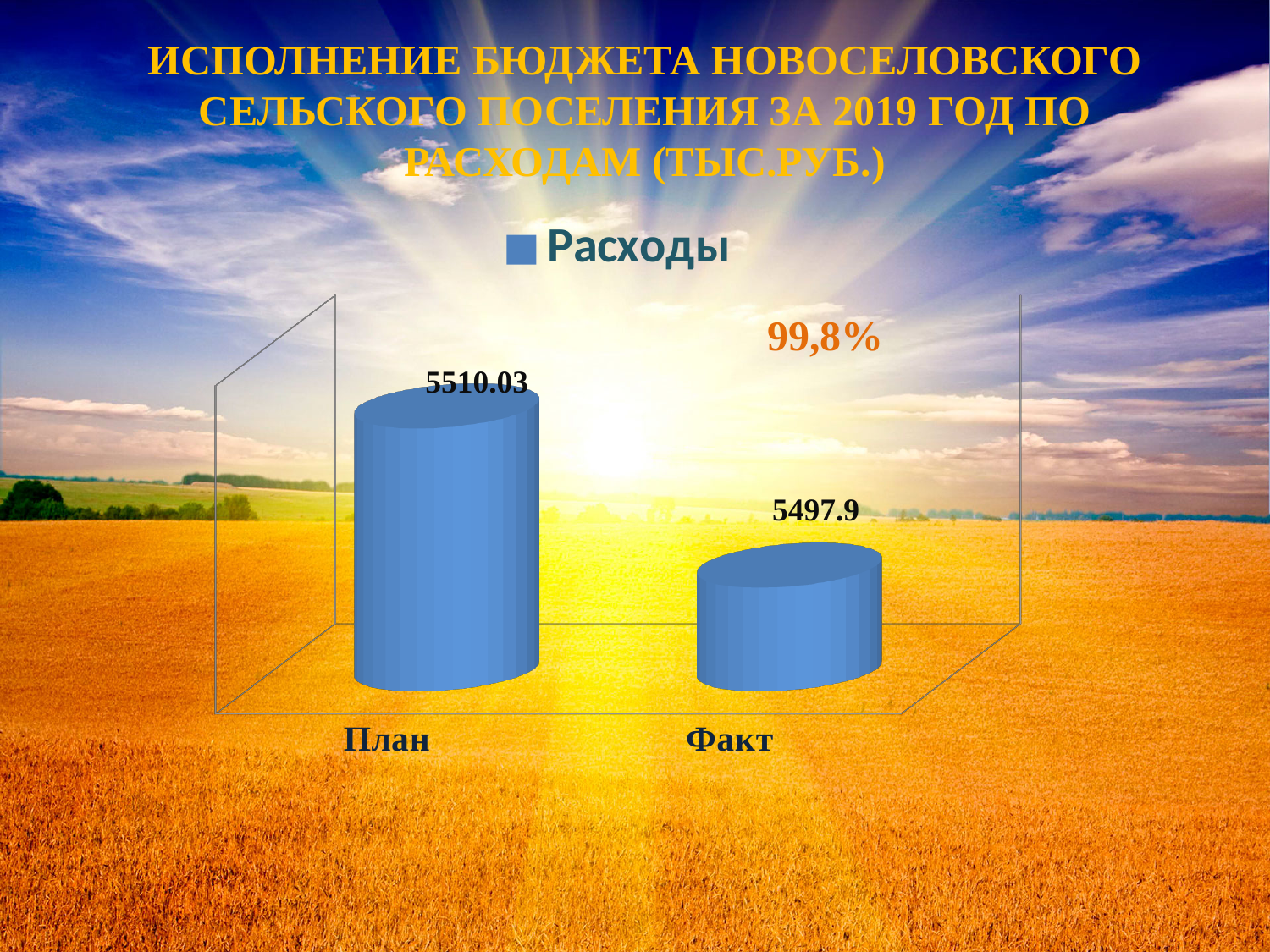
Do the values rise or fall from План to Факт? Fall Which category has the lowest value? Факт What percentage is printed above the Факт bar? 99,8% What series name is shown in the legend? Расходы What is the difference between the values for План and Факт? 12.13 How many series does the legend list? 1 What is the value for Факт? 5497.9 What is the value for План? 5510.03 How many categories are shown in the chart? 2 Which category has the highest value? План Which is larger, the value for План or the value for Факт? План What kind of chart is shown on the slide? Bar chart